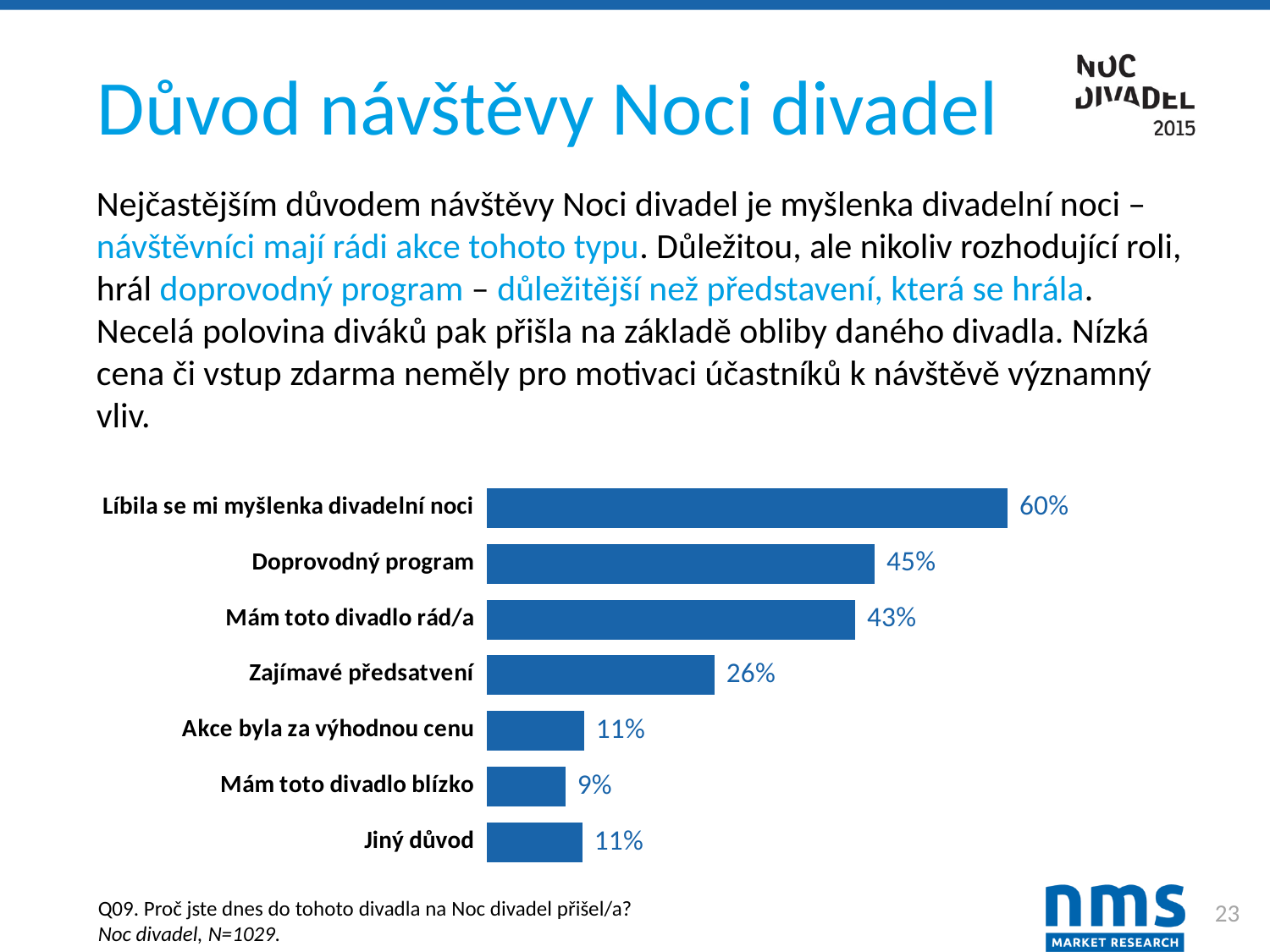
What is the difference between the values for "Líbila se mi myšlenka divadelní noci" and "Doprovodný program"? 15% What kind of chart is shown on the slide? Bar chart Which category has the lowest value? Mám toto divadlo blízko What is the value for "Zajímavé předsatvení"? 26% Which is larger, the value for "Doprovodný program" or the value for "Zajímavé předsatvení"? Doprovodný program What is the value for "Líbila se mi myšlenka divadelní noci"? 60% How many categories are shown in the chart? 7 What is the value for "Akce byla za výhodnou cenu"? 11% Which category has the highest value? Líbila se mi myšlenka divadelní noci What is the difference between the values for "Mám toto divadlo rád/a" and "Zajímavé předsatvení"? 17% What is the value for "Doprovodný program"? 45% What is the value for "Mám toto divadlo blízko"? 9%